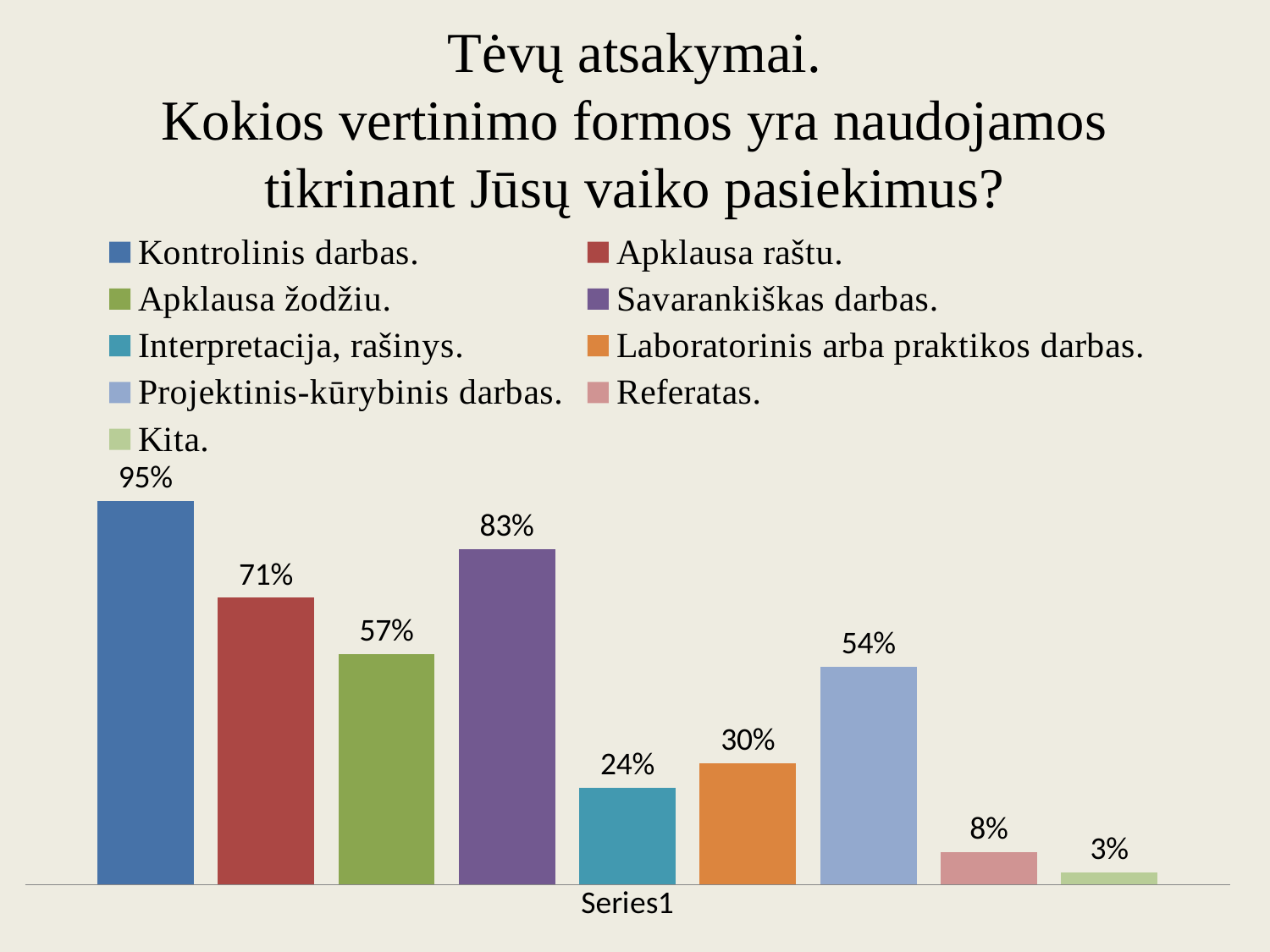
What kind of chart is shown on the slide? Bar chart Which assessment form has the lowest percentage? Kita. What label appears on the horizontal axis below the bars? Series1 What percentage is shown for Kontrolinis darbas? 95% Which assessment form has the highest percentage? Kontrolinis darbas. What percentage is shown for Laboratorinis arba praktikos darbas? 30% What percentage is shown for Savarankiškas darbas? 83% How many entries does the legend list? 9 Which is larger, the value for Projektinis-kūrybinis darbas or the value for Interpretacija, rašinys? Projektinis-kūrybinis darbas. How many bars are plotted in the chart? 9 What is the difference between the percentages for Apklausa raštu and Apklausa žodžiu? 14% What percentage is shown for Referatas? 8%